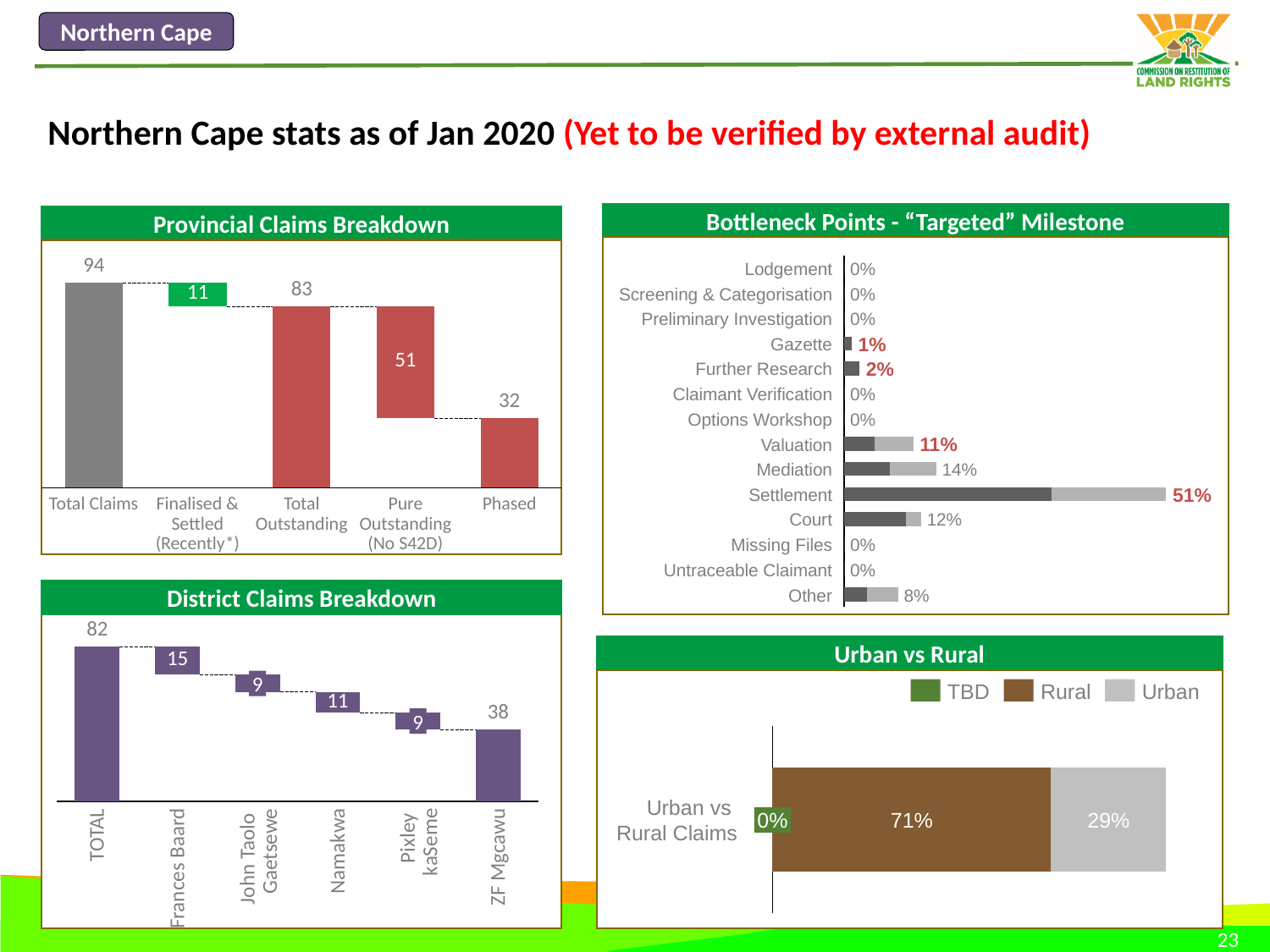
In the Urban vs Rural chart, what is the value for Rural? 71% What kind of chart is the Bottleneck Points - "Targeted" Milestone chart? bar chart In the Bottleneck Points - "Targeted" Milestone chart, which category has the highest value? Settlement In the Provincial Claims Breakdown chart, what is the difference between Total Claims and Total Outstanding? 11 In the Bottleneck Points - "Targeted" Milestone chart, what is the value for Mediation? 14% In the Bottleneck Points - "Targeted" Milestone chart, which is larger, Court or Valuation? Court In the Provincial Claims Breakdown chart, what is the value for Total Claims? 94 In the Bottleneck Points - "Targeted" Milestone chart, how many categories are listed? 14 In the District Claims Breakdown chart, which district (excluding TOTAL) has the highest value? ZF Mgcawu In the District Claims Breakdown chart, how many districts are shown besides TOTAL? 5 In the District Claims Breakdown chart, what is the value for Frances Baard? 15 In the Urban vs Rural chart, how many series does the legend list? 3